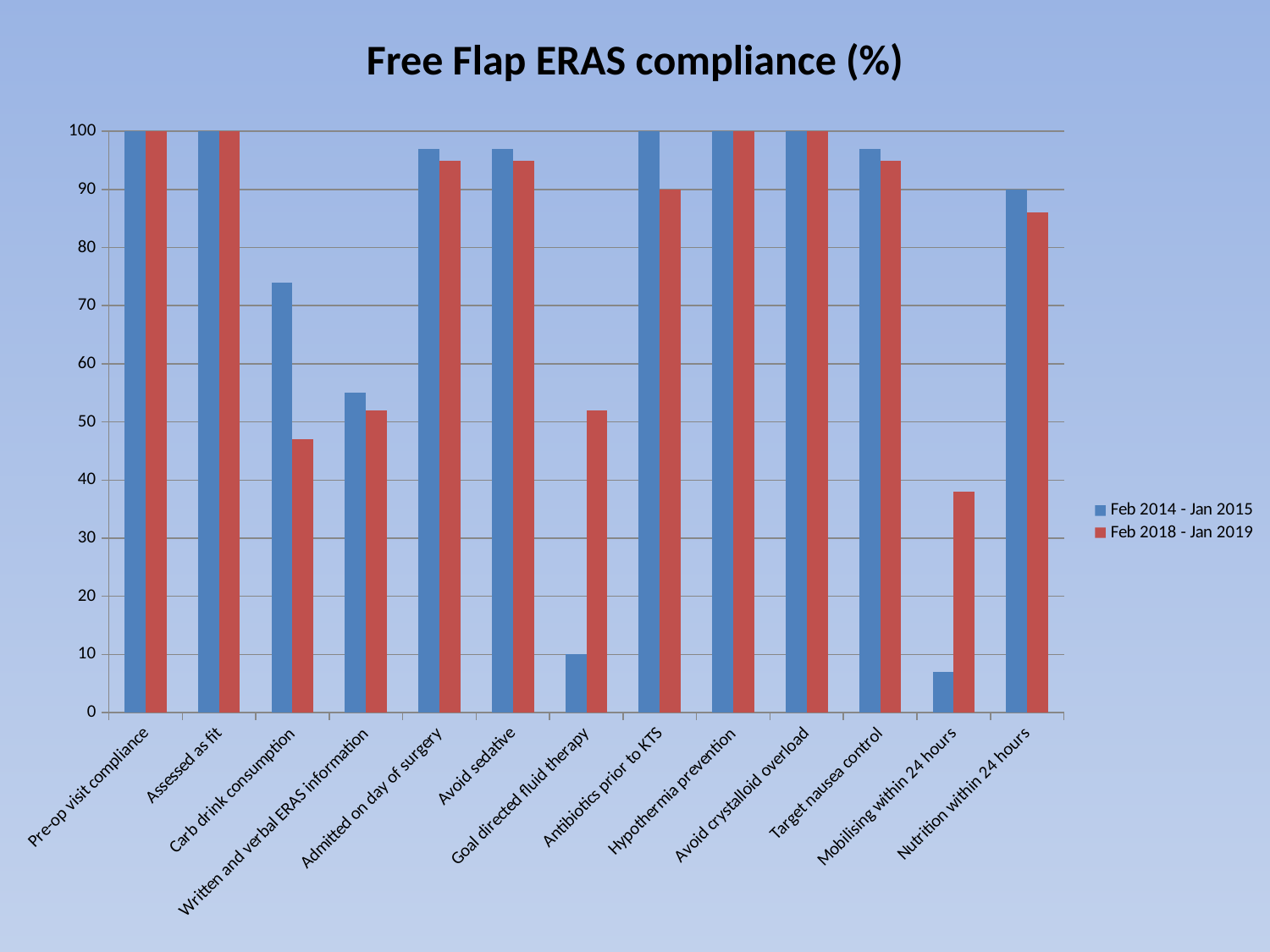
What is the Feb 2014 - Jan 2015 value for Nutrition within 24 hours? 90 What is the Feb 2018 - Jan 2019 value for Antibiotics prior to KTS? 90 Is the Feb 2018 - Jan 2019 value for Mobilising within 24 hours greater or less than 30? greater How many series does the legend list? 2 What is the Feb 2014 - Jan 2015 value for Pre-op visit compliance? 100 Is the Feb 2014 - Jan 2015 value for Carb drink consumption greater or less than 60? greater What is the Feb 2014 - Jan 2015 value for Goal directed fluid therapy? 10 Which category has the lowest Feb 2014 - Jan 2015 value? Mobilising within 24 hours What is the difference between the Feb 2014 - Jan 2015 values for Pre-op visit compliance and Goal directed fluid therapy? 90 How many categories are shown on the x axis? 13 For Goal directed fluid therapy, which series has the larger value, Feb 2014 - Jan 2015 or Feb 2018 - Jan 2019? Feb 2018 - Jan 2019 What kind of chart is shown on the slide? bar chart